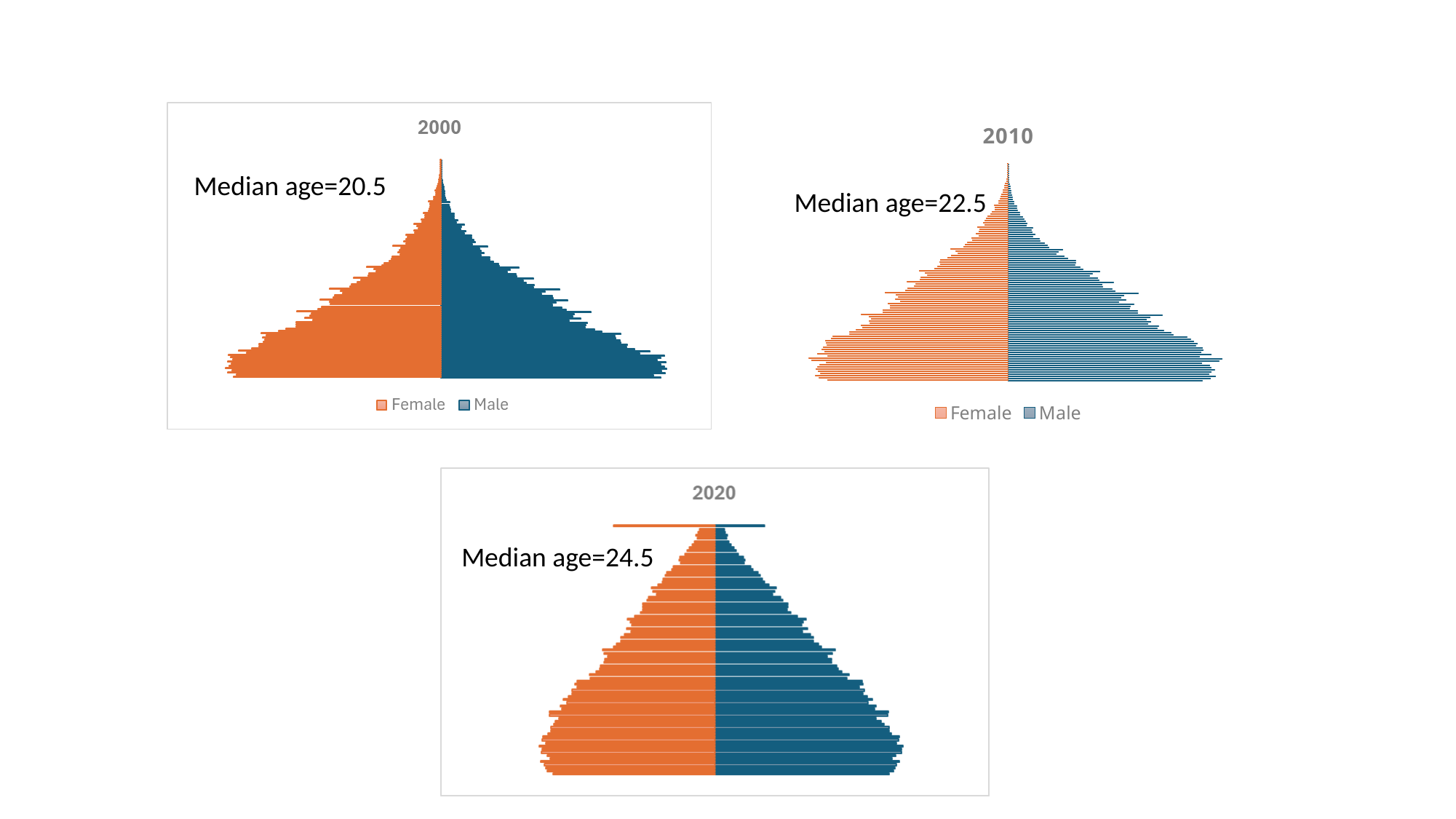
What median age is stated on the chart titled 2020? 24.5 Is the median age stated on the 2010 chart greater or less than the median age stated on the 2020 chart? less Which chart states the lowest median age: 2000, 2010 or 2020? 2000 Does the stated median age rise or fall from the 2000 chart to the 2010 chart to the 2020 chart? rise Which colour represents the Female series in the chart titled 2000? orange How many series does the legend of the chart titled 2010 list? 2 What median age is stated on the chart titled 2010? 22.5 What median age is stated on the chart titled 2000? 20.5 What kind of chart is the chart titled 2000? bar chart What is the difference between the median age stated on the 2020 chart and the median age stated on the 2000 chart? 4 Which chart states the highest median age: 2000, 2010 or 2020? 2020